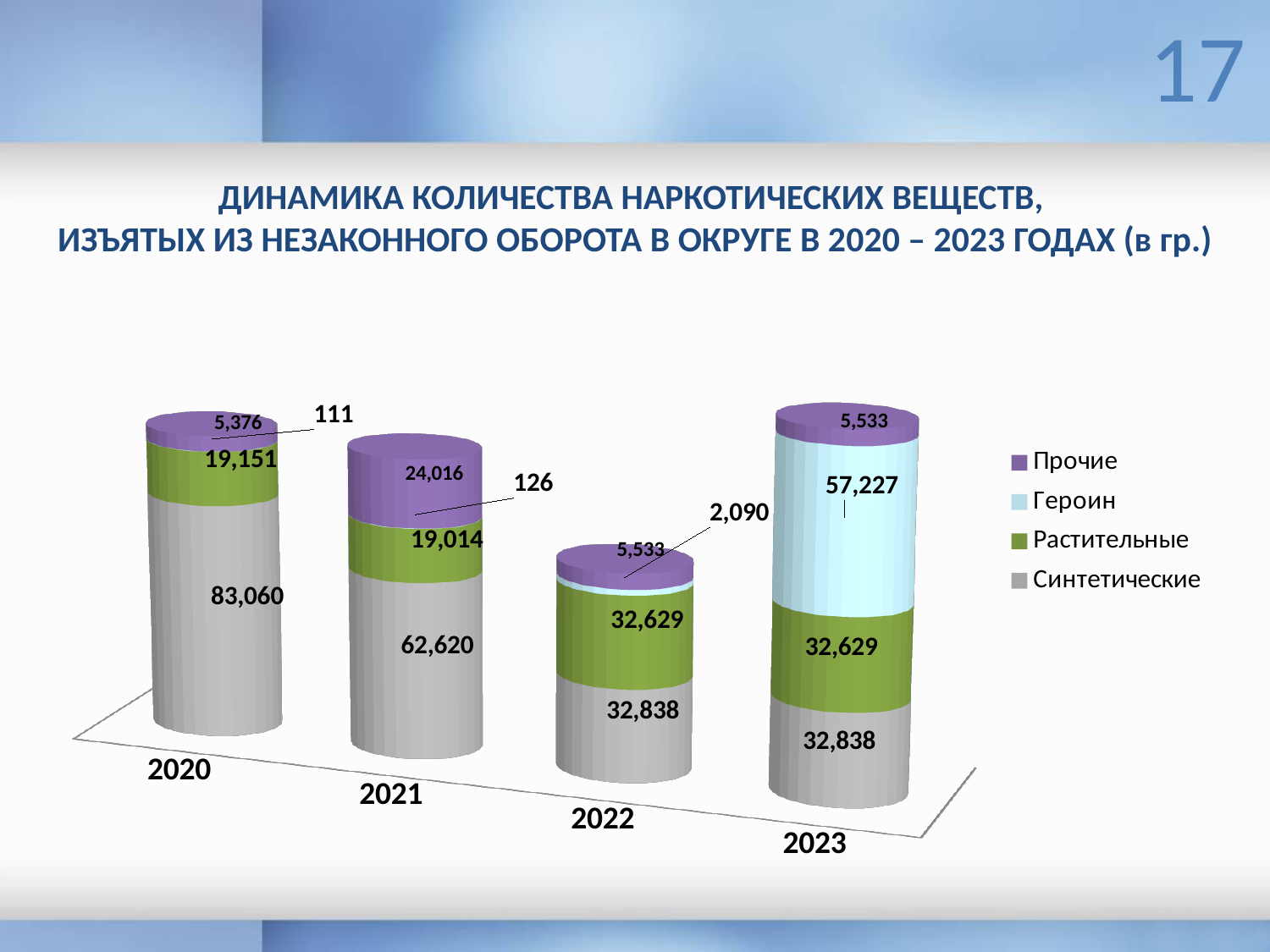
How many years are shown on the x axis? 4 How many series does the legend list? 4 What is the value for Синтетические in 2020? 83,060 What is the value for Прочие in 2021? 24,016 In which year is the value for Героин the lowest? 2020 What is the value for Растительные in 2022? 32,629 What is the difference between the Синтетические values for 2020 and 2021? 20,440 What is the value for Героин in 2023? 57,227 In which year is the value for Синтетические the highest? 2020 What is the total of the stacked bar for 2023? 128,227 Which is larger: the Прочие value in 2021 or the Прочие value in 2020? 2021 What kind of chart is shown on the slide? Stacked bar chart